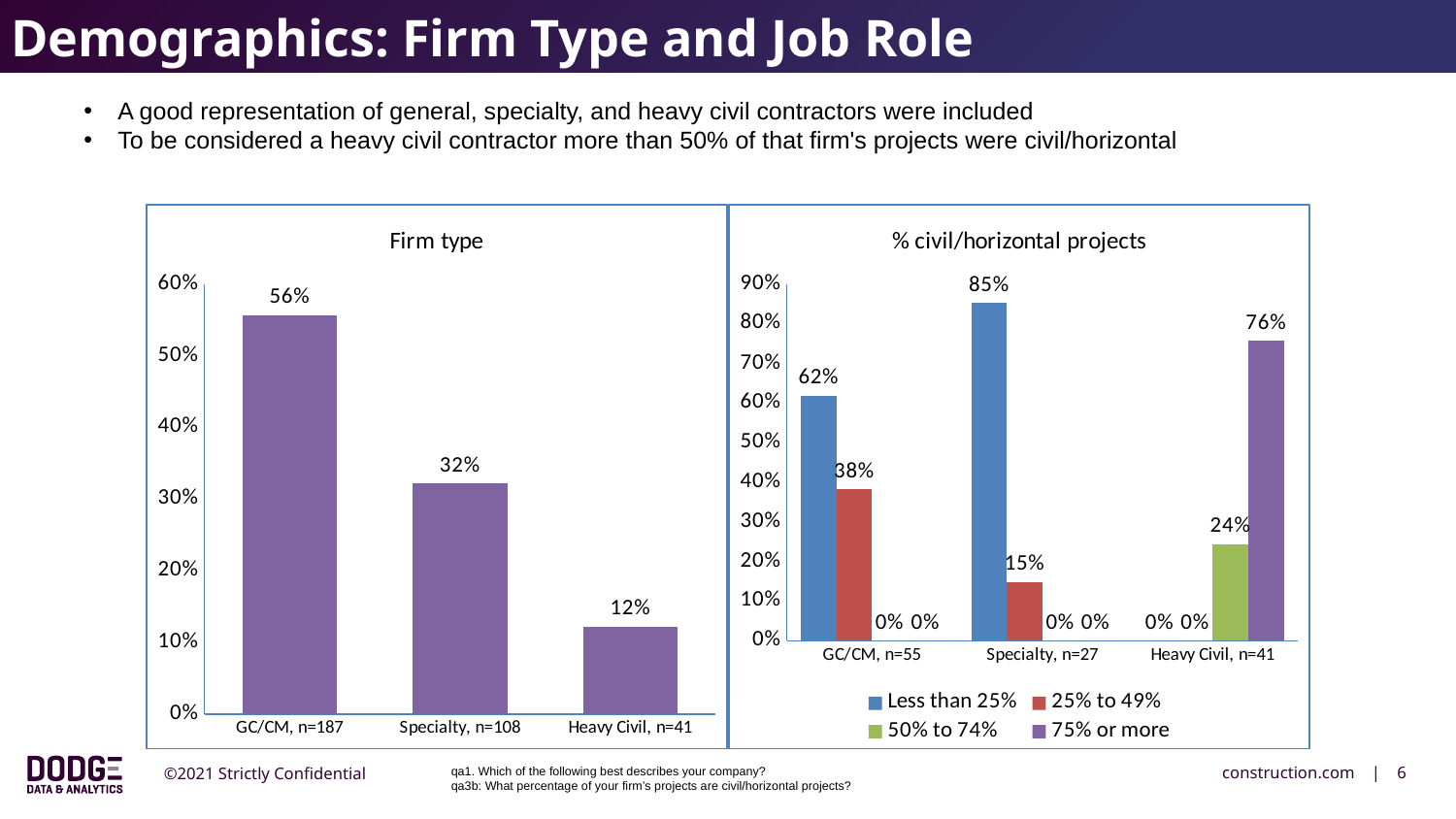
What kind of chart is the 'Firm type' chart? Bar chart In the '% civil/horizontal projects' chart, which legend entry is shown in green? 50% to 74% In the '% civil/horizontal projects' chart, what is the difference between the 'Less than 25%' values for Specialty, n=27 and GC/CM, n=55? 23% In the '% civil/horizontal projects' chart, which is larger for GC/CM, n=55: 'Less than 25%' or '25% to 49%'? Less than 25% In the 'Firm type' chart, which category has the lowest value? Heavy Civil, n=41 In the 'Firm type' chart, how many categories are shown? 3 In the '% civil/horizontal projects' chart, what is the value for '25% to 49%' for GC/CM, n=55? 38% In the 'Firm type' chart, what is the difference between the values for GC/CM, n=187 and Specialty, n=108? 24% In the 'Firm type' chart, what is the value for GC/CM, n=187? 56% In the '% civil/horizontal projects' chart, how many series does the legend list? 4 In the '% civil/horizontal projects' chart, what is the value for 'Less than 25%' for Specialty, n=27? 85% In the '% civil/horizontal projects' chart, what is the value for '75% or more' for Heavy Civil, n=41? 76%